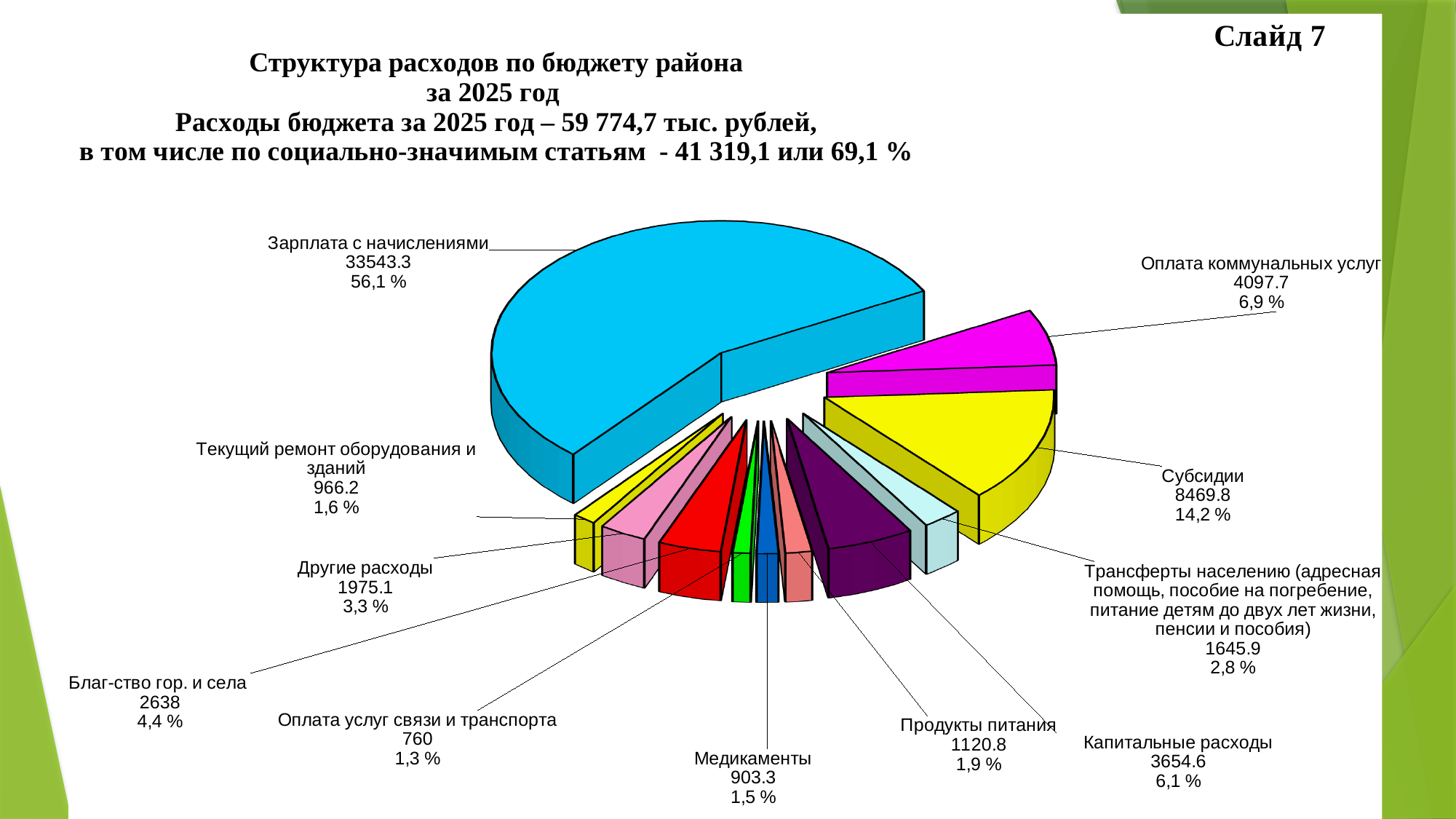
Which category has the largest slice of the pie? Зарплата с начислениями What is the value shown for "Капитальные расходы"? 3654.6 What type of chart is shown on the slide? pie chart How many slices does the pie chart have? 11 What percentage is shown for "Медикаменты"? 1,5 % What is the title of the chart on the slide? Структура расходов по бюджету района за 2025 год What is the difference between the values for "Благ-ство гор. и села" and "Другие расходы"? 662.9 What is the value shown for "Продукты питания"? 1120.8 What is the value shown for "Зарплата с начислениями"? 33543.3 What share of the pie does "Субсидии" represent? 14,2 % Which category has the smallest slice of the pie? Оплата услуг связи и транспорта Which is larger, "Оплата коммунальных услуг" or "Капитальные расходы"? Оплата коммунальных услуг